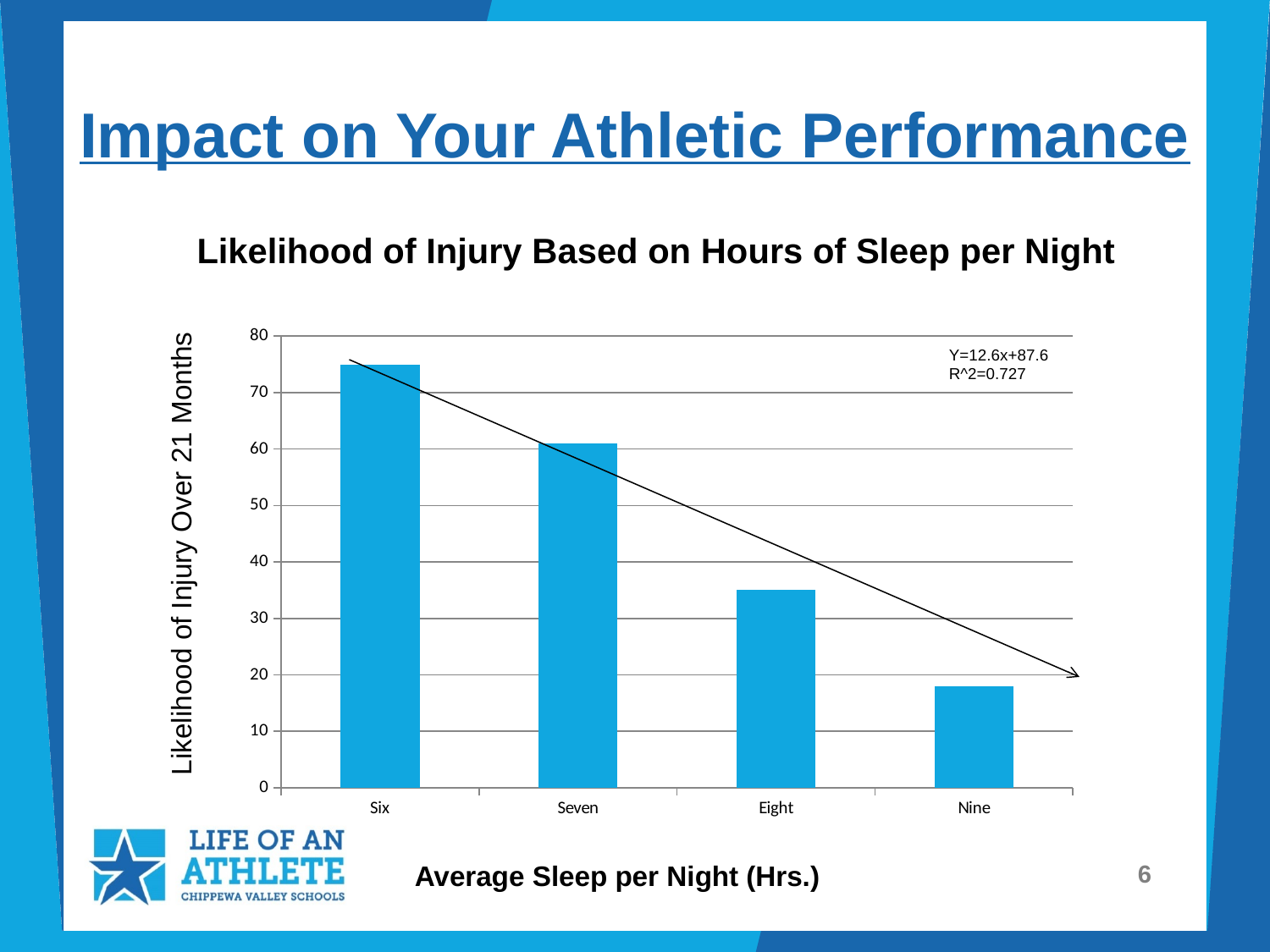
Do the bar values rise or fall as average sleep per night increases from Six to Nine hours? fall Is the likelihood of injury for Nine hours of sleep greater or less than 20? less What is the label of the x axis? Average Sleep per Night (Hrs.) How many sleep categories are plotted on the x axis? 4 Is the likelihood of injury for Eight hours of sleep greater or less than 40? less What is the title of the chart? Likelihood of Injury Based on Hours of Sleep per Night Is the likelihood of injury for Seven hours of sleep greater or less than 50? greater Which has a higher likelihood of injury, Seven hours or Eight hours of sleep? Seven Which sleep category has the lowest likelihood of injury? Nine Which sleep category has the highest likelihood of injury? Six What kind of chart is shown on the slide? bar chart